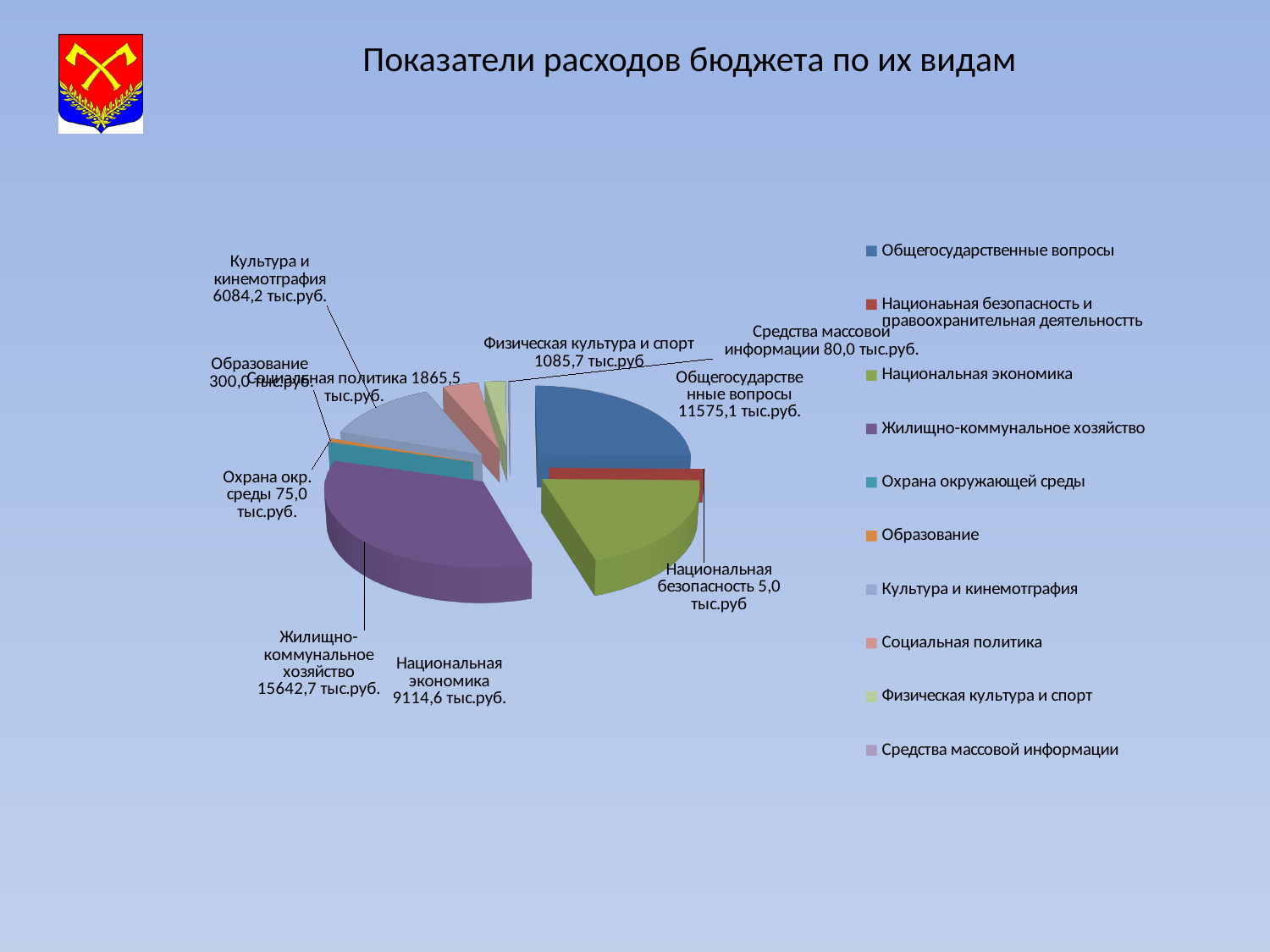
What is the value for Культура и кинемотграфия? 6084,2 тыс.руб. What is the difference between Жилищно-коммунальное хозяйство and Общегосударственные вопросы? 4067,6 тыс.руб. What is the value for Жилищно-коммунальное хозяйство? 15642,7 тыс.руб. What is the title of the chart? Показатели расходов бюджета по их видам Which category has the largest value? Жилищно-коммунальное хозяйство What is the value for Средства массовой информации? 80,0 тыс.руб. Which is larger: Социальная политика or Физическая культура и спорт? Социальная политика What is the value for Общегосударственные вопросы? 11575,1 тыс.руб. What type of chart is shown on the slide? Pie chart What is the value for Национальная экономика? 9114,6 тыс.руб. Which category has the smallest value? Национальная безопасность How many categories does the legend list? 10